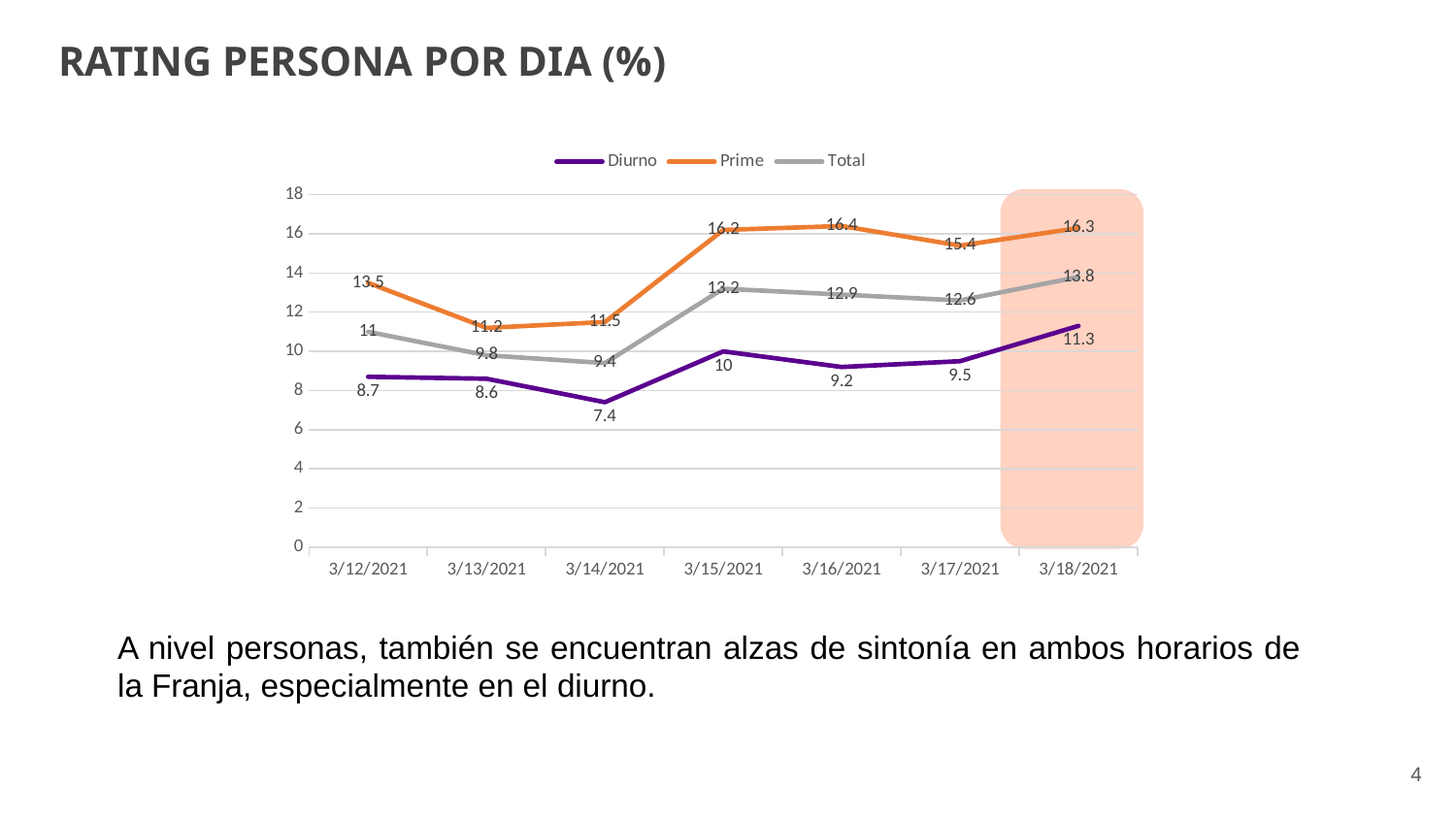
What is the difference between the Prime and Diurno values on 3/18/2021? 5 On which date is the Prime series highest? 3/16/2021 What is the Prime value on 3/16/2021? 16.4 On which date is the Diurno series lowest? 3/14/2021 What is the title of the chart on the slide? RATING PERSONA POR DIA (%) What is the Diurno value on 3/14/2021? 7.4 Which is larger, the Total value on 3/15/2021 or the Total value on 3/17/2021? 3/15/2021 Is the Diurno value on 3/18/2021 greater or less than 10? greater How many series does the legend list? 3 How many dates are shown on the x axis? 7 What kind of chart is shown on the slide? line chart What is the Total value on 3/18/2021? 13.8